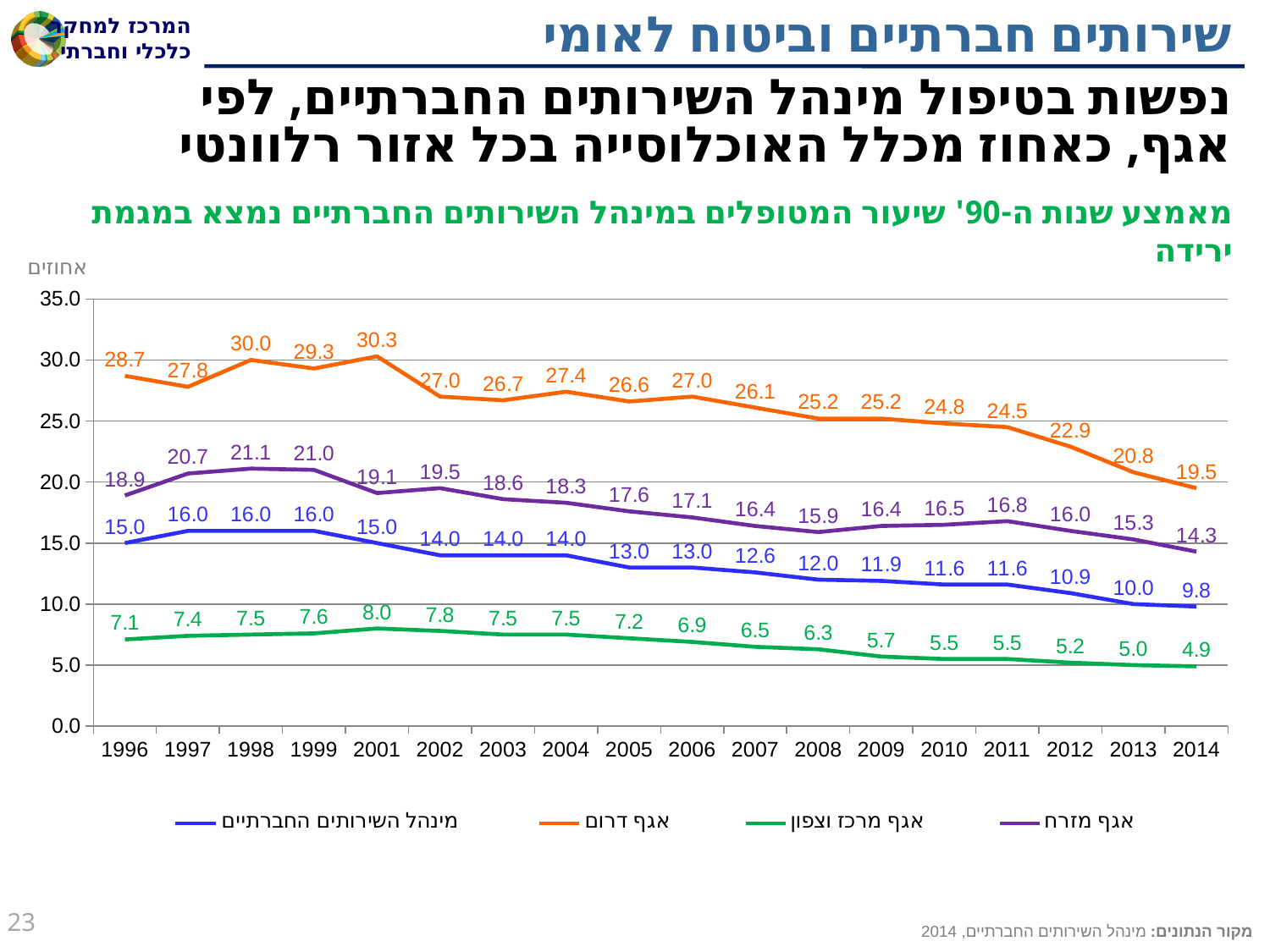
In which year does אגף דרום reach its highest value? 2001 What is the value for אגף מרכז וצפון in 2014? 4.9 What is the value for אגף דרום in 2001? 30.3 What type of chart is shown on the slide? line chart In which year does מינהל השירותים החברתיים have its lowest value? 2014 What is the value for אגף מזרח in 1998? 21.1 How many years are shown on the x axis? 18 How many series does the legend list? 4 Which series has the higher value in 2010, אגף מזרח or מינהל השירותים החברתיים? אגף מזרח What is the unit label shown above the y axis? אחוזים What is the difference between the אגף דרום value in 1996 and in 2014? 9.2 Does the value for אגף מרכז וצפון rise or fall from 2001 to 2014? fall